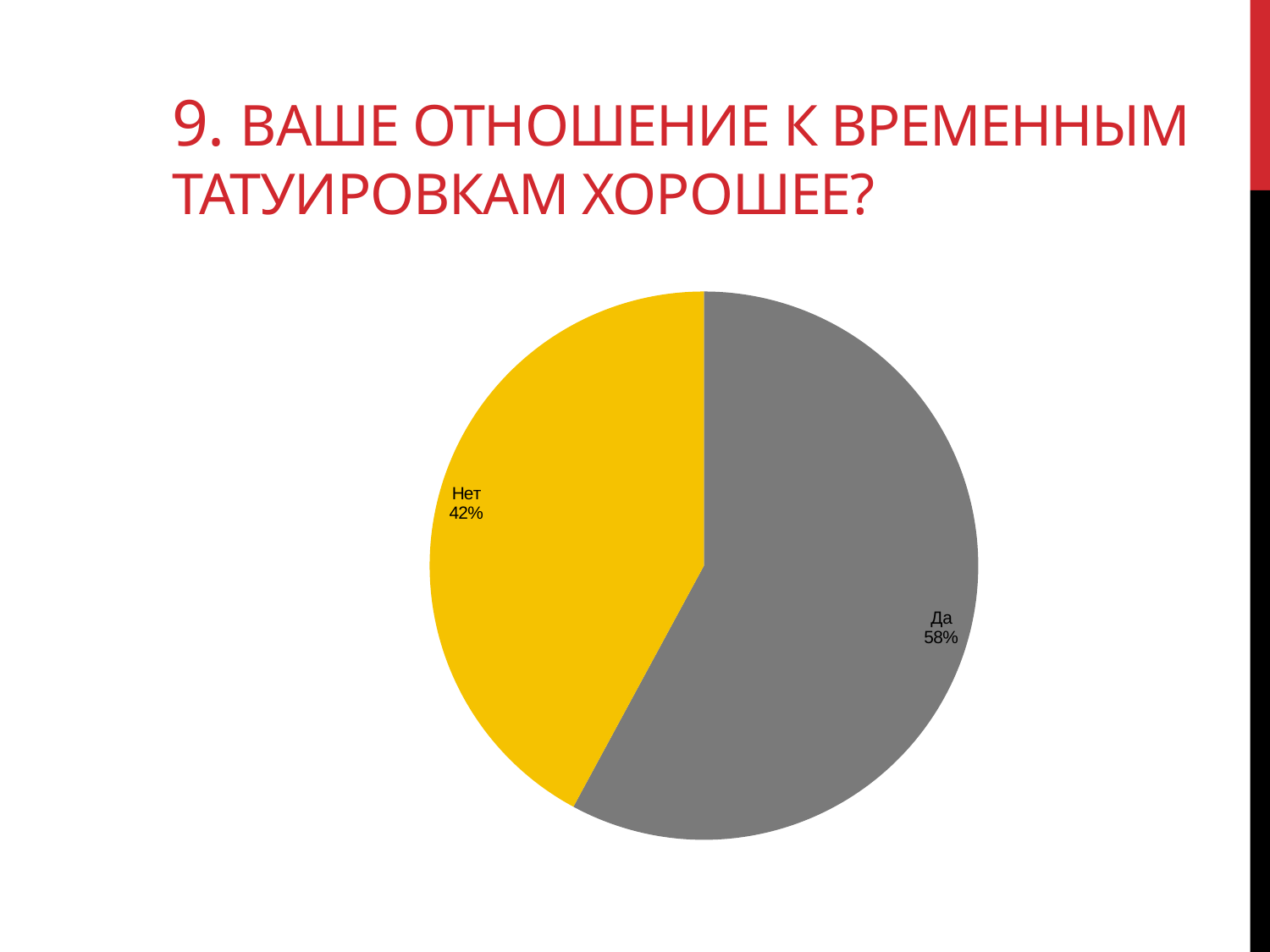
What kind of chart is shown on the slide? pie chart What share of the pie does the "Нет" slice represent? 42% What share of the pie does the "Да" slice represent? 58% Which slice is the smallest in the pie chart? Нет Which is larger, the "Да" slice or the "Нет" slice? Да How many slices does the pie chart have? 2 Which slice is the largest in the pie chart? Да What colour is the "Да" slice? grey What colour is the "Нет" slice? yellow What is the difference in percentage points between the "Да" and "Нет" slices? 16%